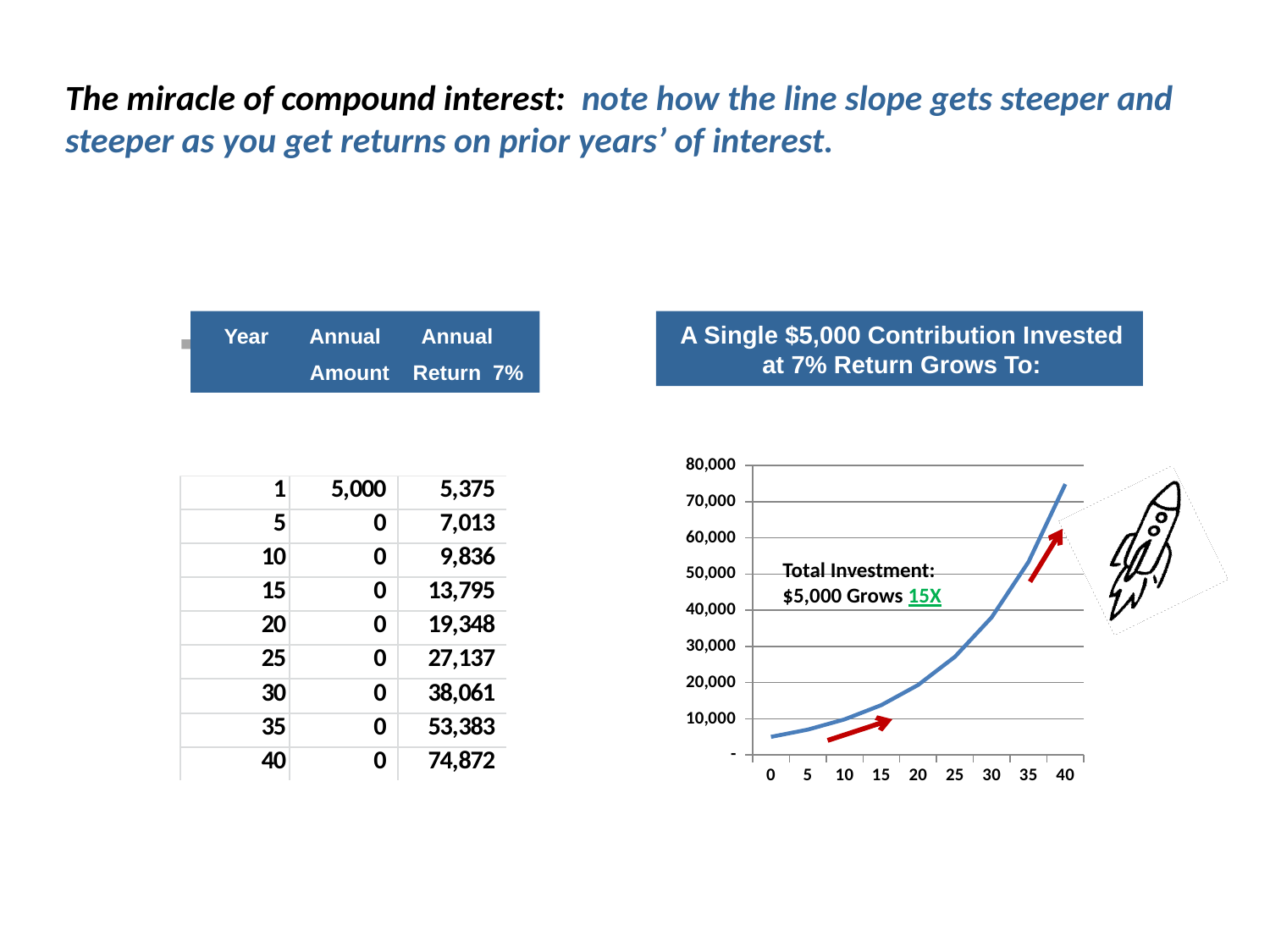
Is the value of the line at year 40 greater or less than 70,000? greater What type of chart is shown on the slide? line chart Is the value of the line at year 0 greater or less than 10,000? less Is the value of the line at year 35 greater or less than 50,000? greater What is the highest value labelled on the y axis of the chart? 80,000 How many tick labels are shown on the x axis of the chart? 9 According to the table on the slide, what is the annual return value at year 40? 74,872 Does the line rise or fall as the year increases along the x axis? rise What is the title of the chart? A Single $5,000 Contribution Invested at 7% Return Grows To: According to the table on the slide, what is the annual return value at year 20? 19,348